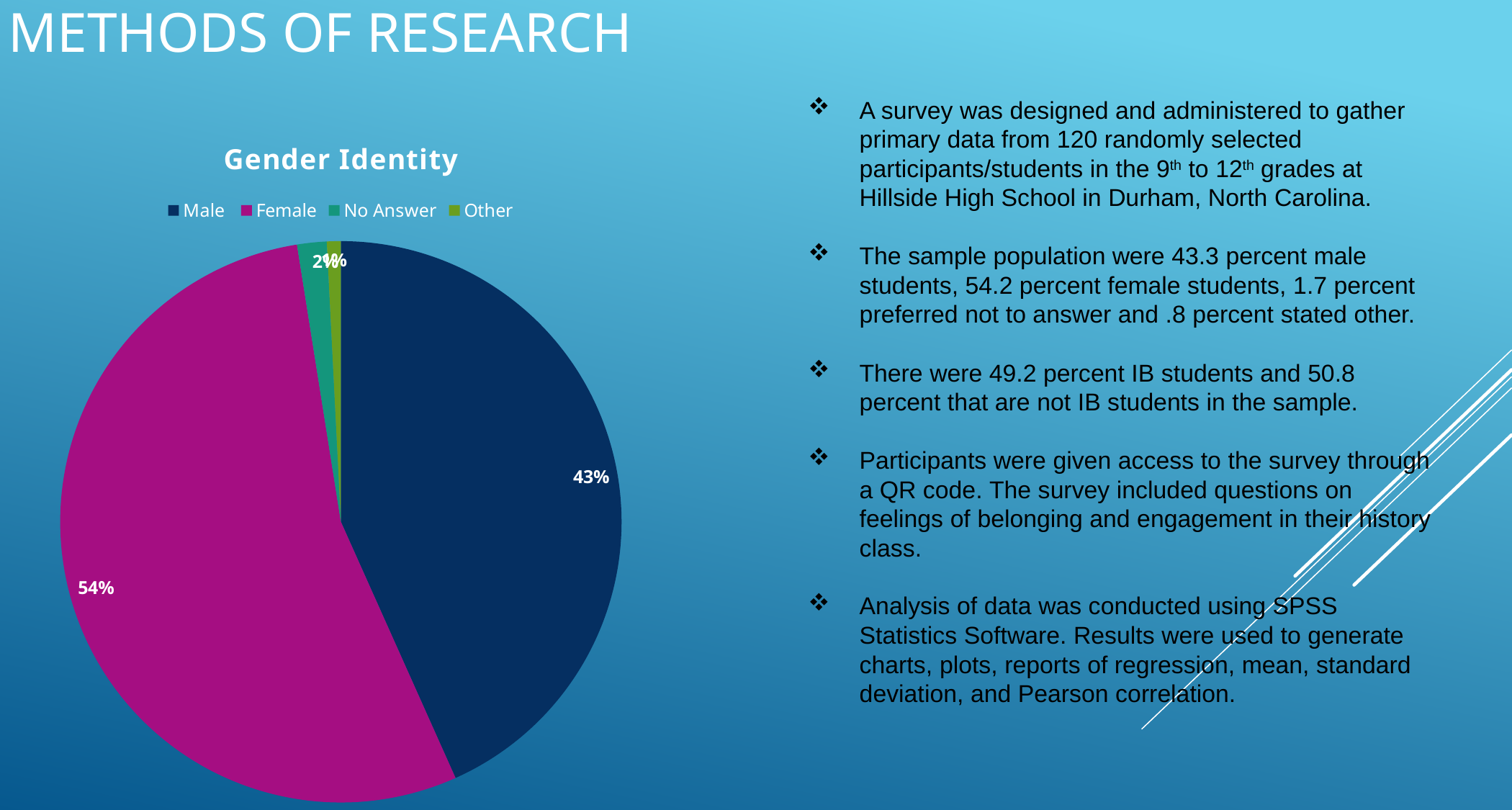
Which slice is larger, Male or Female? Female What colour is the Female slice in the pie chart? Magenta What percentage of the Gender Identity pie is Female? 54% What do the Male and Female slices add up to? 97% What percentage of the Gender Identity pie is No Answer? 2% By how many percentage points does the Female slice exceed the Male slice? 11 percentage points What kind of chart is shown on the slide? Pie chart Which category has the smallest slice of the Gender Identity pie? Other What percentage of the Gender Identity pie is Male? 43% How many categories does the Gender Identity pie chart have? 4 Which category has the largest slice of the Gender Identity pie? Female What is the title of the chart? Gender Identity